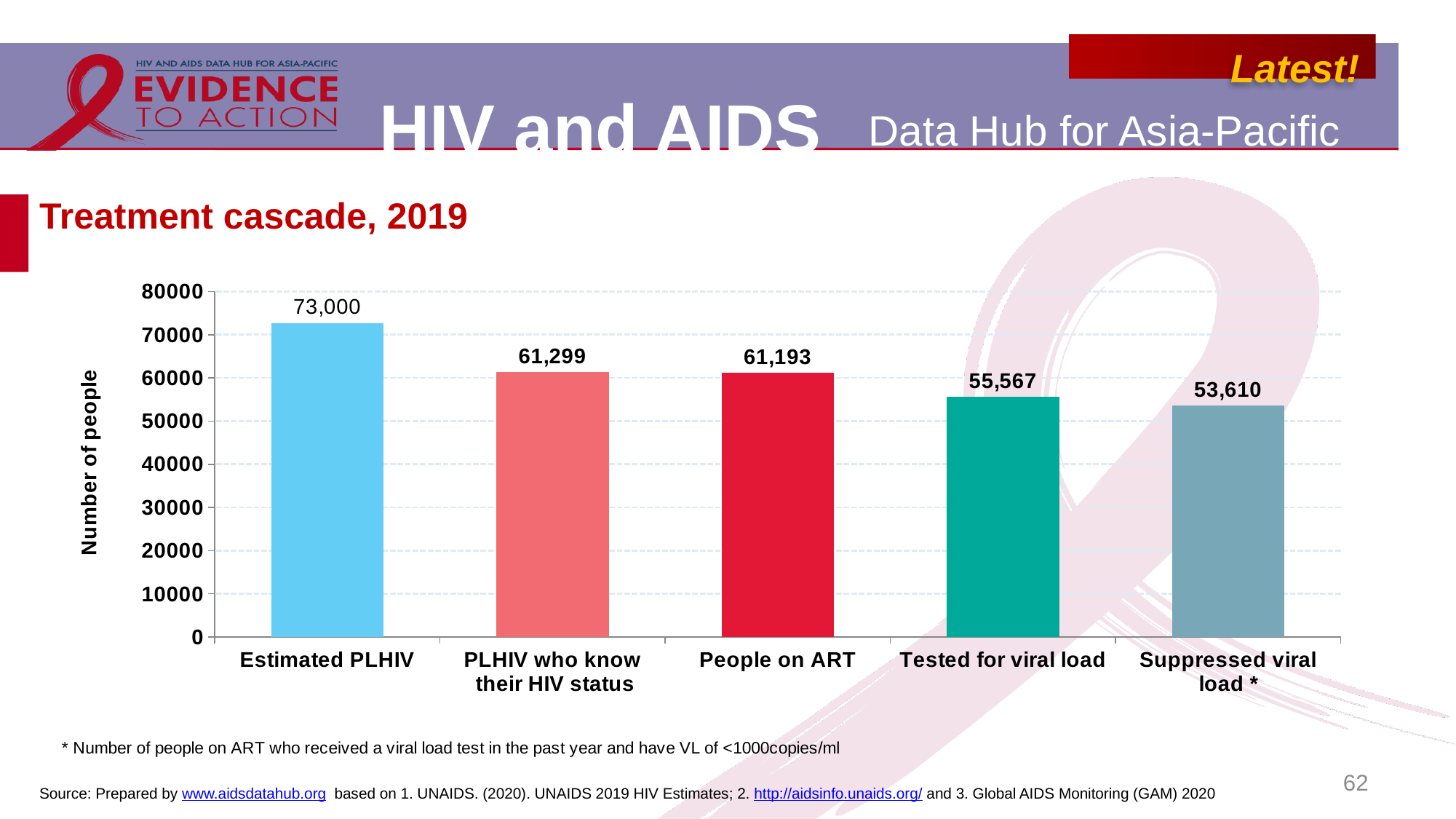
What kind of chart is shown on the slide? Bar chart What is the value for Tested for viral load? 55,567 What is the value for Estimated PLHIV? 73,000 What is the value for PLHIV who know their HIV status? 61,299 What is the value for Suppressed viral load? 53,610 Which category has the highest value? Estimated PLHIV Which category has the lowest value? Suppressed viral load * What is the difference between Tested for viral load and Suppressed viral load? 1,957 What is the difference between Estimated PLHIV and People on ART? 11,807 Is the value for Tested for viral load greater or less than 60000? less How many categories are shown in the chart? 5 What is the value for People on ART? 61,193